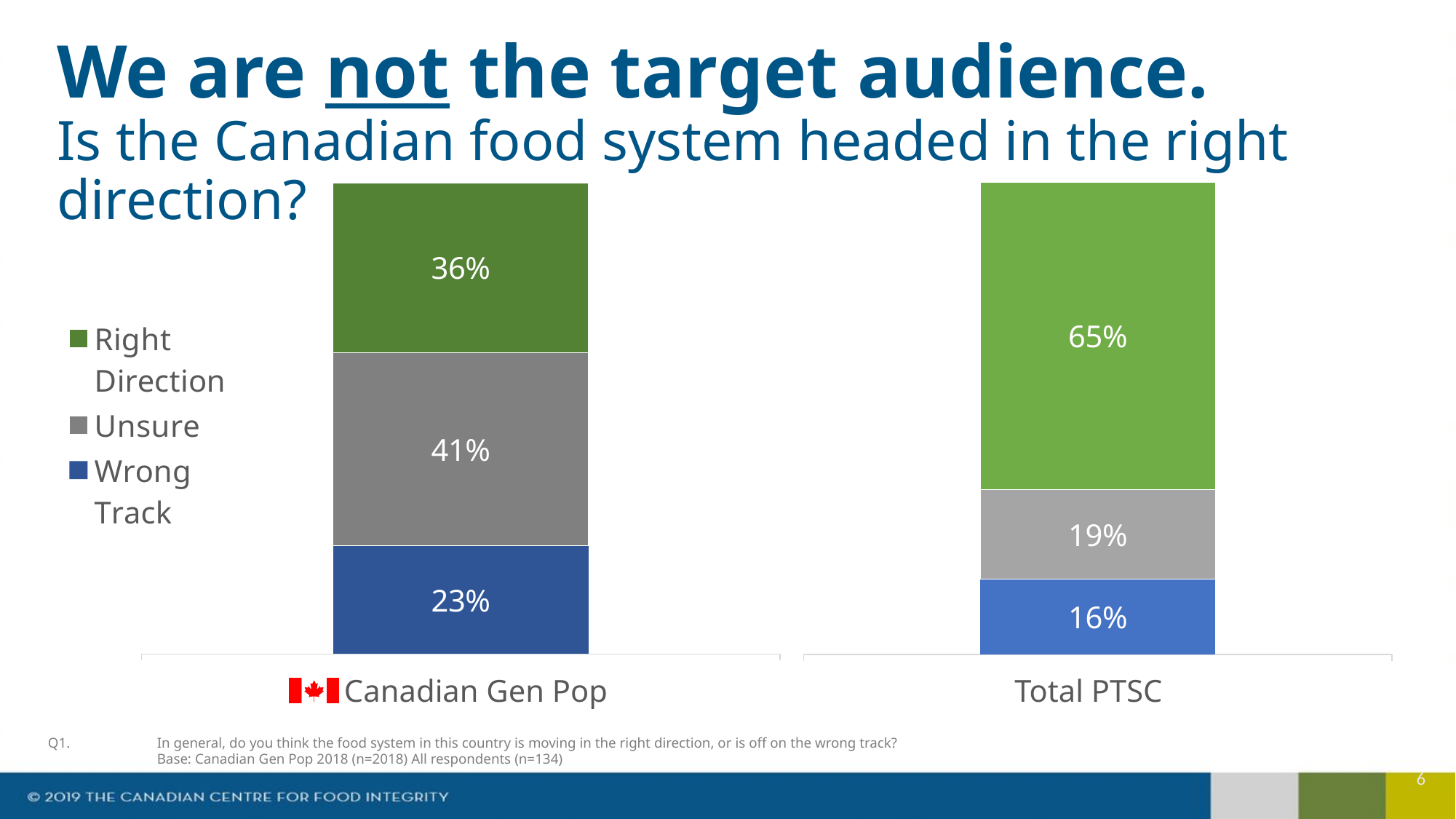
What percentage of Total PTSC respondents said the food system is headed in the Right Direction? 65% What type of chart is shown on the slide? Stacked bar chart What is the Wrong Track value for Total PTSC? 16% Which group has the higher Right Direction percentage, Canadian Gen Pop or Total PTSC? Total PTSC What is the Unsure value for Canadian Gen Pop? 41% Which response is the largest segment in the Canadian Gen Pop bar? Unsure What percentage of Canadian Gen Pop respondents said the food system is headed in the Right Direction? 36% Which response is the smallest segment in the Total PTSC bar? Wrong Track What is the difference between the Unsure percentages for Canadian Gen Pop and Total PTSC? 22 percentage points How many series does the legend list? 3 What is the difference between the Right Direction percentages for Total PTSC and Canadian Gen Pop? 29 percentage points How many groups (bars) are shown in the chart? 2